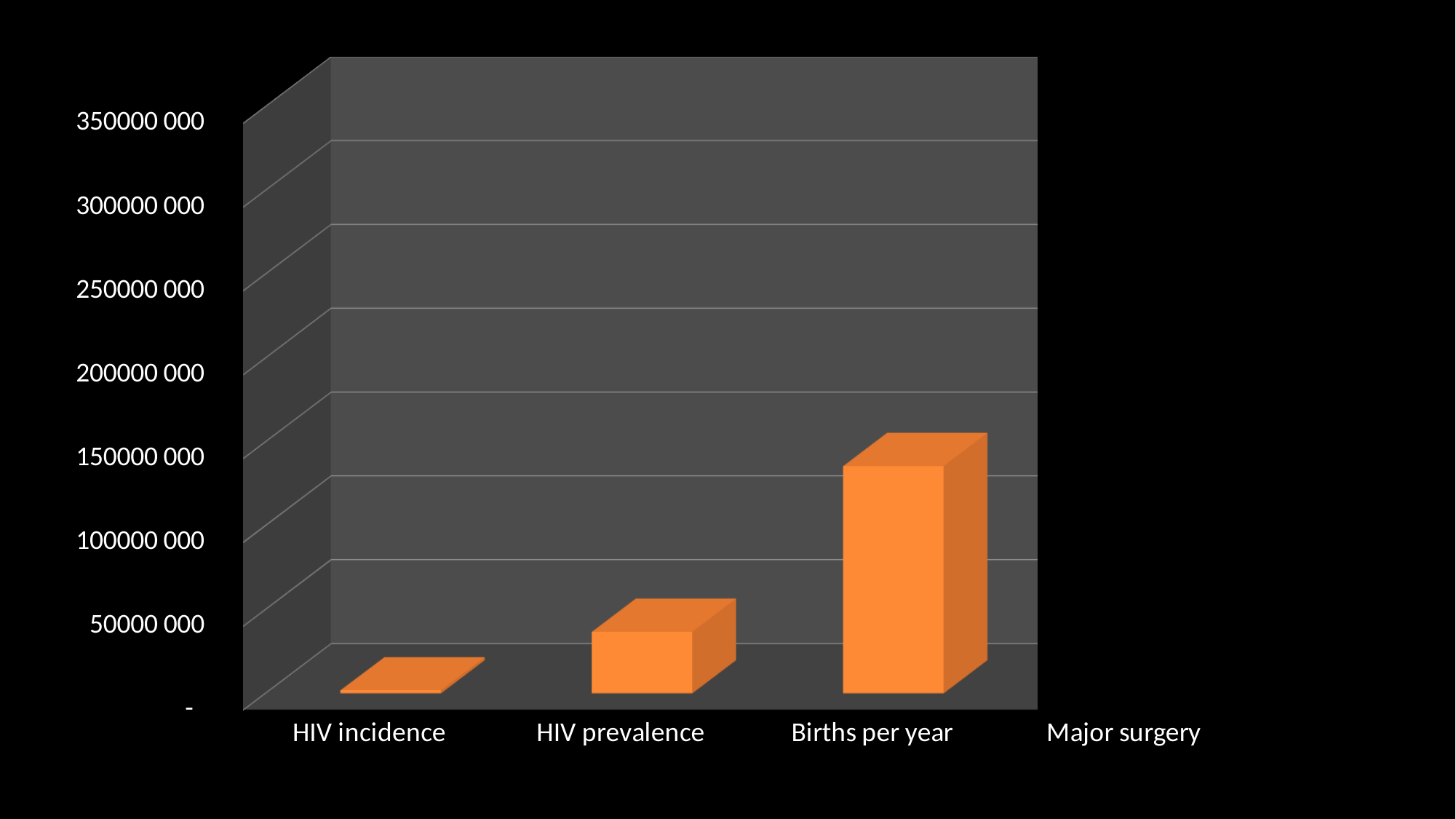
Which is larger, the value for HIV prevalence or the value for Births per year? Births per year Which category has the tallest bar in the chart? Births per year Which is larger, the value for HIV incidence or the value for HIV prevalence? HIV prevalence How many categories are labelled on the x axis of the chart? 4 Is the value for Births per year greater or less than 200000 000? less Is the value for Births per year greater or less than 100000 000? greater What colour are the bars in the chart? orange Do the bar values rise or fall from HIV incidence to Births per year? rise Is the value for HIV prevalence greater or less than 100000 000? less What is the highest value labelled on the vertical axis of the chart? 350000 000 What kind of chart is shown on the slide? bar chart